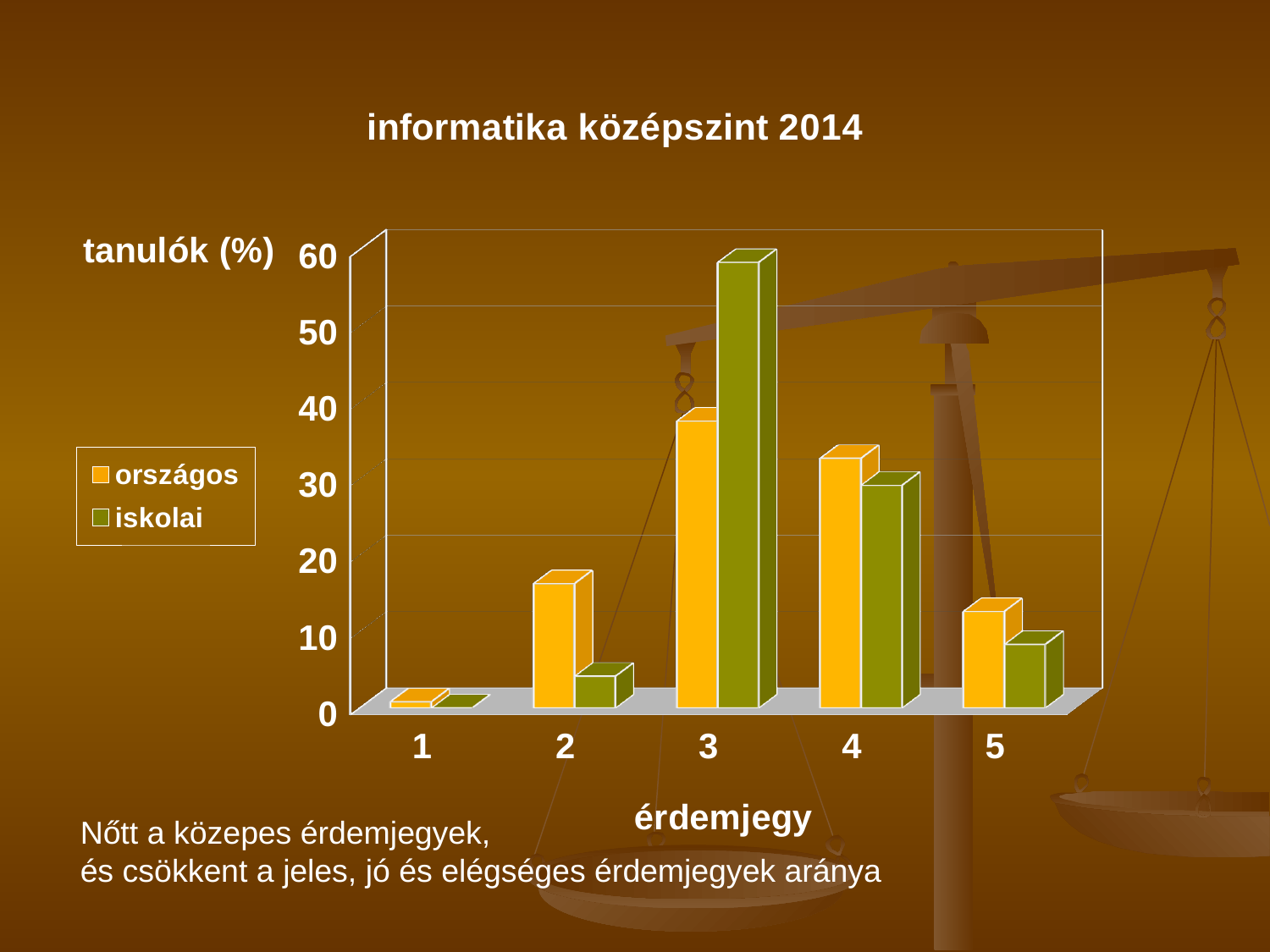
For grade 2, which series has the larger value, országos or iskolai? országos How many series does the legend list? 2 Which grade has the highest value for the országos series? 3 For grade 3, which series has the larger value, országos or iskolai? iskolai Is the országos value for grade 2 greater or less than 20? less Which grade has the highest value for the iskolai series? 3 What is the title of the chart? informatika középszint 2014 What is the label of the vertical axis? tanulók (%) How many grade categories (érdemjegy) are shown on the x axis? 5 Is the iskolai value for grade 3 greater or less than 50? greater What kind of chart is shown on the slide? bar chart Which grade has the lowest value for the országos series? 1